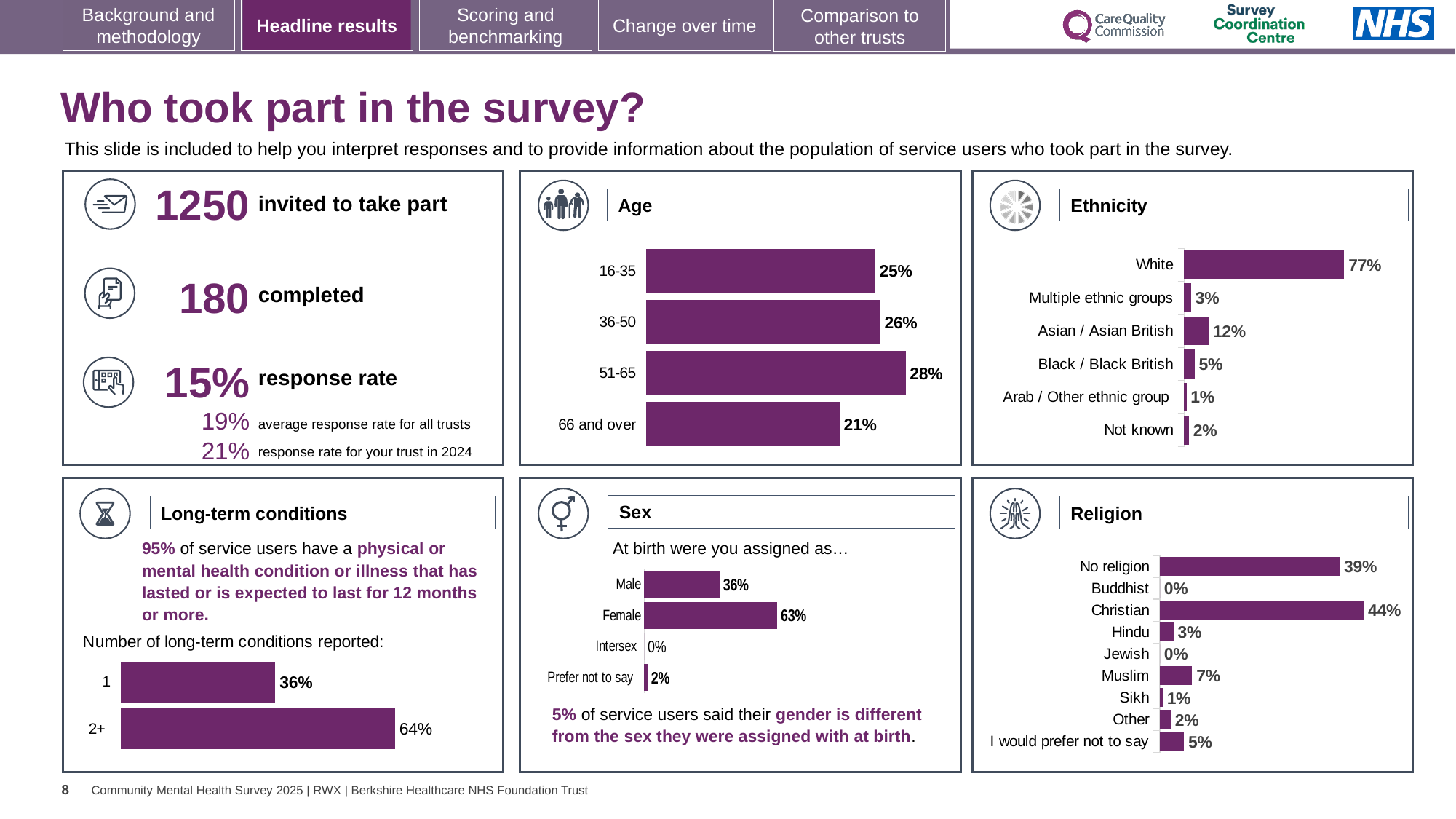
In the Sex chart, what percentage of respondents were assigned Female at birth? 63% In the Religion chart, which category has the highest value? Christian What kind of chart is used in the Age panel? Bar chart In the Ethnicity chart, what is the difference between White and Asian / Asian British? 65% How many categories are shown in the Ethnicity chart? 6 In the Sex chart, which is larger, Male or Female? Female In the Age chart, what percentage of respondents were aged 51-65? 28% In the Long-term conditions chart, what percentage of service users reported 2+ long-term conditions? 64% In the Religion chart, what is the value for Christian? 44% In the Ethnicity chart, which category has the highest value? White In the Age chart, which age group has the lowest percentage? 66 and over In the Ethnicity chart, what is the value for Asian / Asian British? 12%